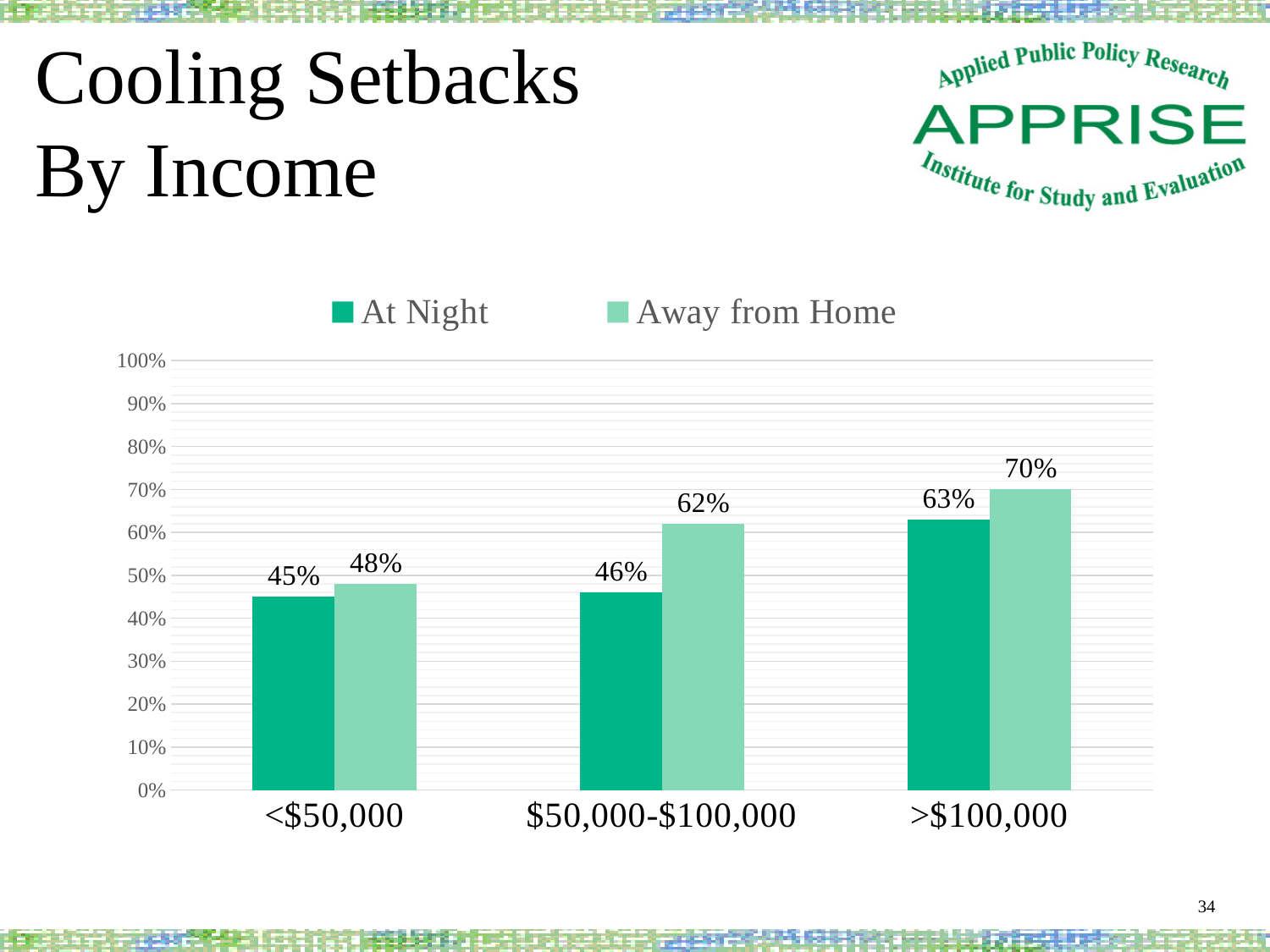
What is the At Night value for the >$100,000 income group? 63% Which is larger for the <$50,000 group: At Night or Away from Home? Away from Home How many income groups are shown on the x axis? 3 What is the difference between the Away from Home and At Night values for the $50,000-$100,000 group? 16% Is the Away from Home value for the >$100,000 group greater or less than 60%? greater How many series does the legend list? 2 Do the At Night values rise or fall as income increases along the x axis? Rise Which income group has the highest Away from Home value? >$100,000 What is the At Night value for the <$50,000 income group? 45% What kind of chart is shown on the slide? Bar chart What is the Away from Home value for the $50,000-$100,000 income group? 62% Which income group has the lowest At Night value? <$50,000